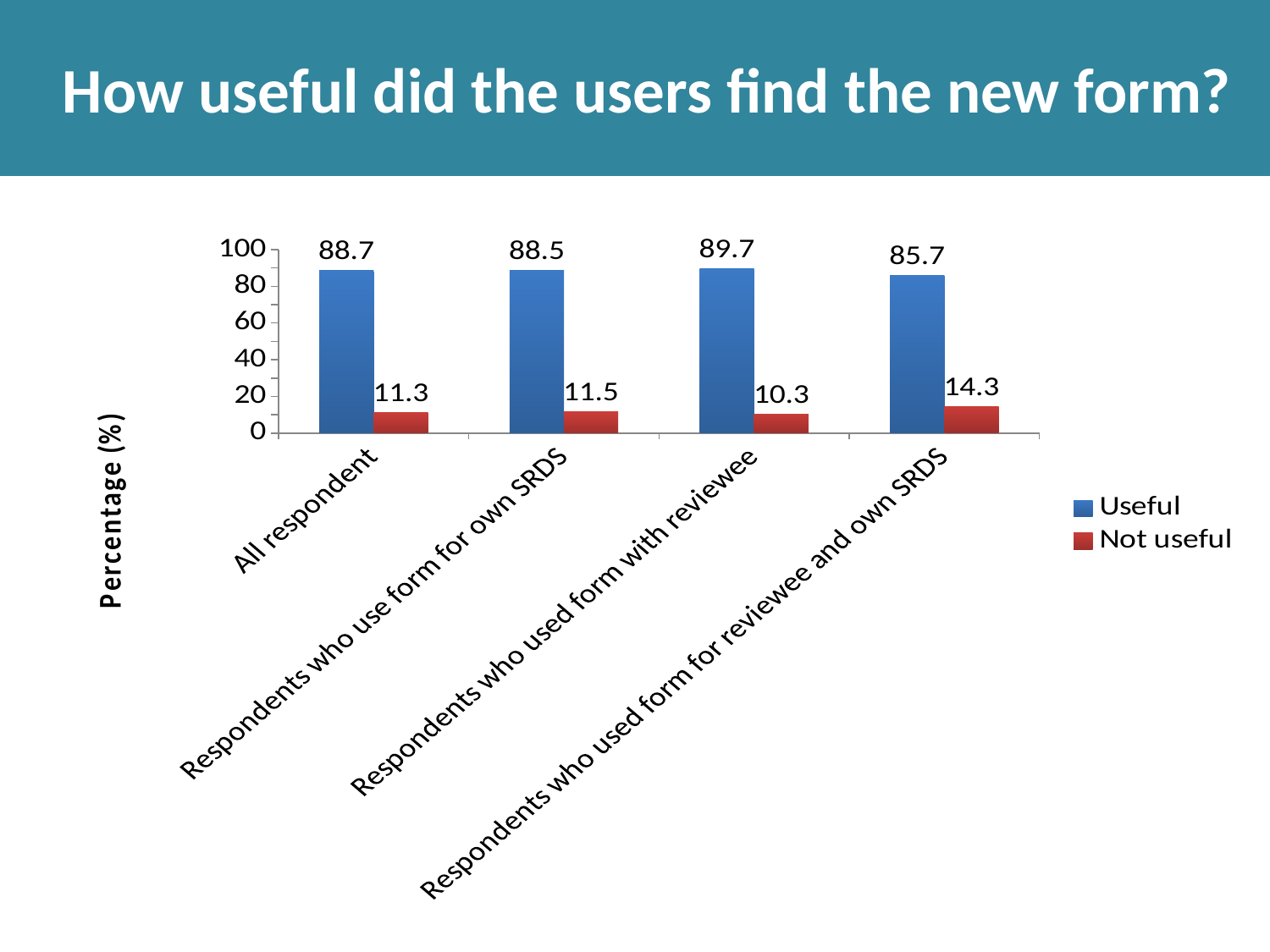
Which category has the lowest Useful value? Respondents who used form for reviewee and own SRDS Which is larger: the Useful value for Respondents who use form for own SRDS or for Respondents who used form for reviewee and own SRDS? Respondents who use form for own SRDS What is the label of the vertical axis? Percentage (%) What kind of chart is shown on the slide? Bar chart How many series does the legend list? 2 What is the Not useful value for Respondents who used form with reviewee? 10.3 What is the Not useful value for Respondents who used form for reviewee and own SRDS? 14.3 Which category has the highest Not useful value? Respondents who used form for reviewee and own SRDS How many categories are shown on the x axis? 4 What is the Useful value for All respondent? 88.7 Which category has the highest Useful value? Respondents who used form with reviewee What is the difference between the Useful and Not useful values for All respondent? 77.4